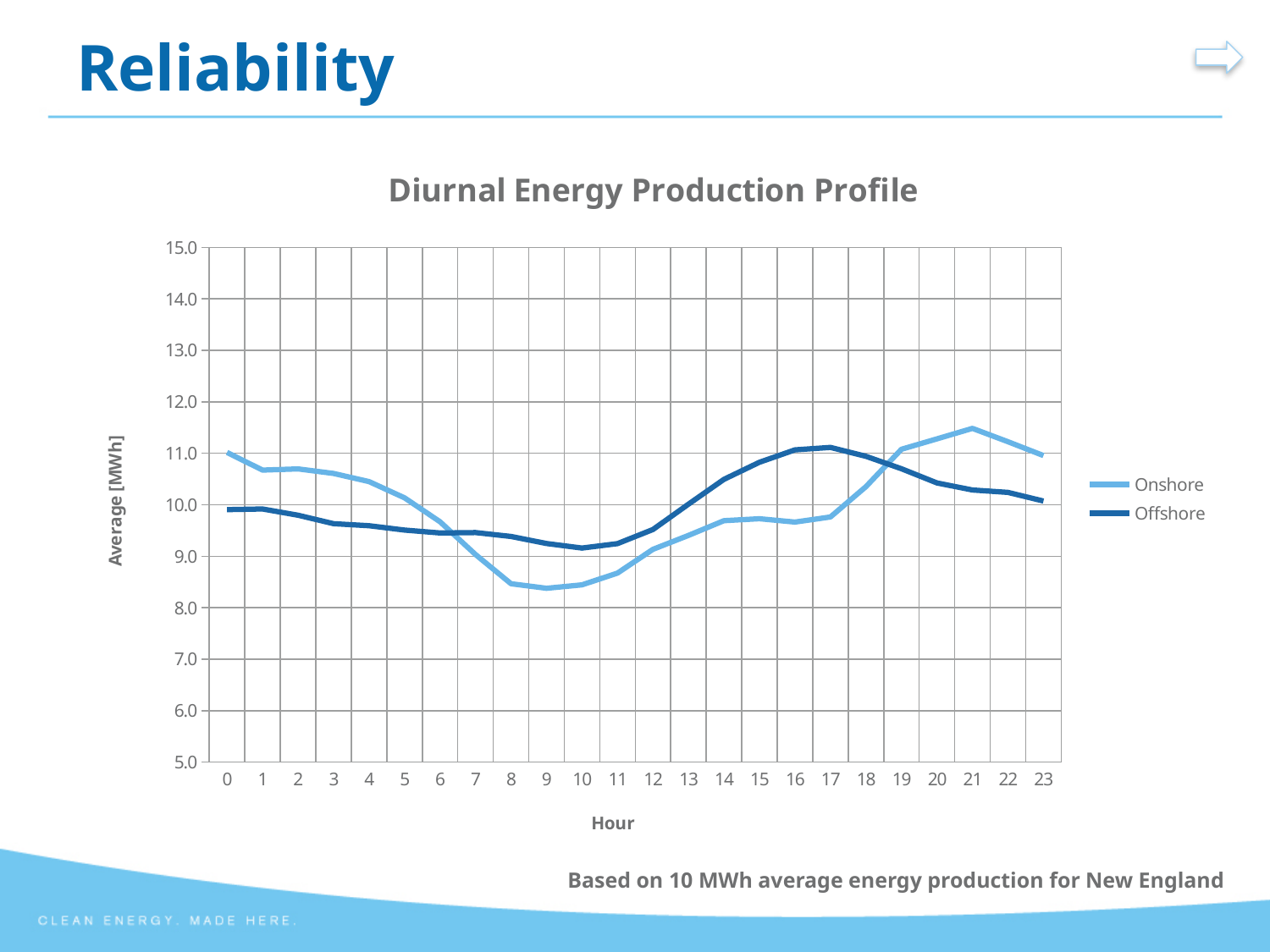
At hour 21, which series has the higher value, Onshore or Offshore? Onshore Is the Onshore value at hour 0 greater or less than 10.0? greater What kind of chart is shown on the slide? line chart How many hours are plotted along the x axis? 24 Is the Offshore value at hour 10 greater or less than 10.0? less How many series does the legend list? 2 At hour 16, which series has the higher value, Onshore or Offshore? Offshore At which hour does the Onshore series reach its highest value? 21 Is the Onshore value at hour 9 greater or less than 9.0? less What is the title of the chart? Diurnal Energy Production Profile Does the Onshore series rise or fall from hour 0 to hour 9? fall